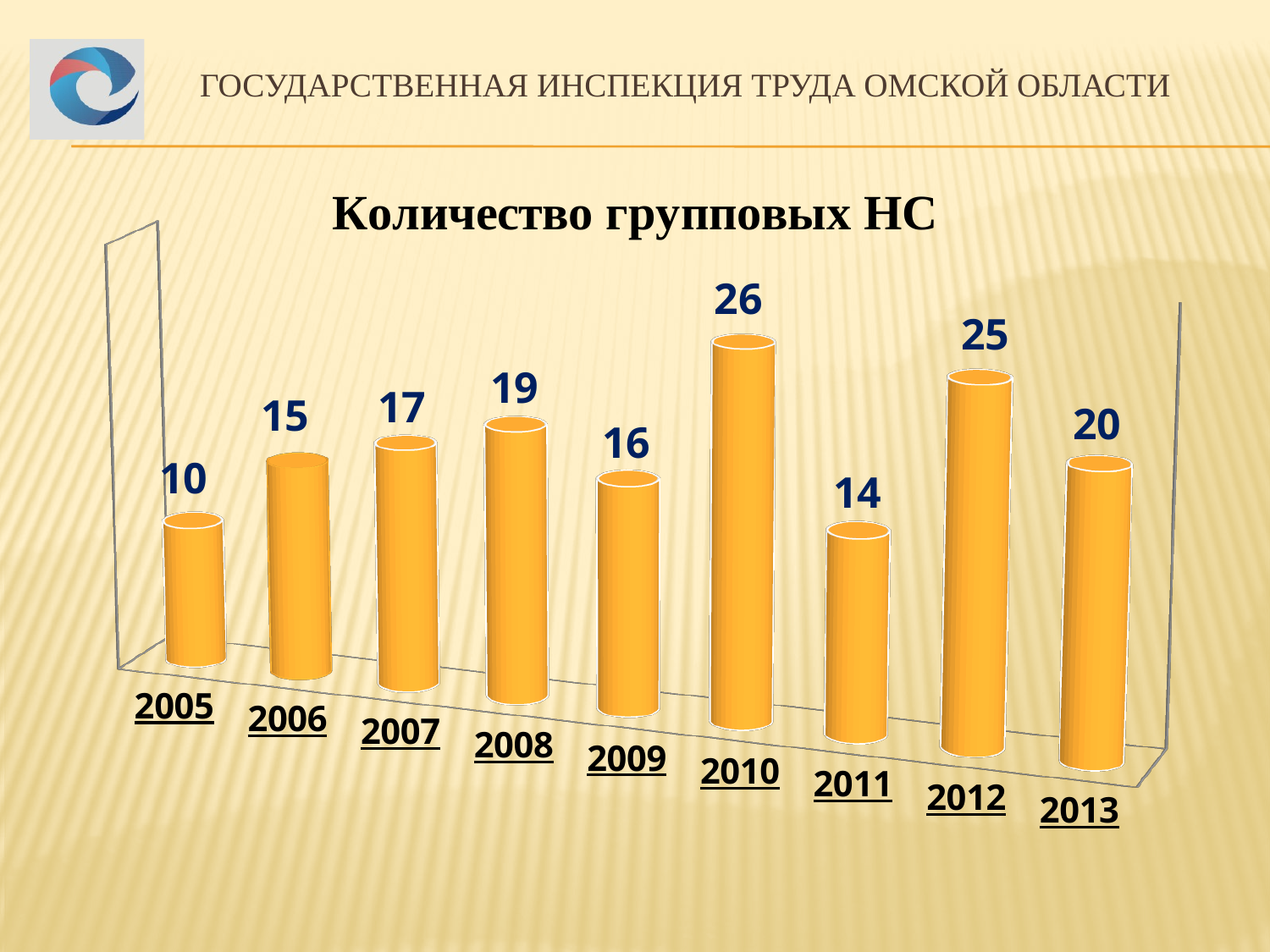
Do the values rise or fall from 2005 to 2008? rise What is the value for 2010? 26 What is the difference between the values for 2013 and 2005? 10 What is the value for 2012? 25 Which is larger, the value for 2008 or the value for 2009? 2008 How many years are shown on the chart? 9 What is the title of the chart? Количество групповых НС What is the difference between the values for 2010 and 2011? 12 What is the value for 2005? 10 Which year has the lowest value? 2005 Which year has the highest value? 2010 What kind of chart is this? bar chart